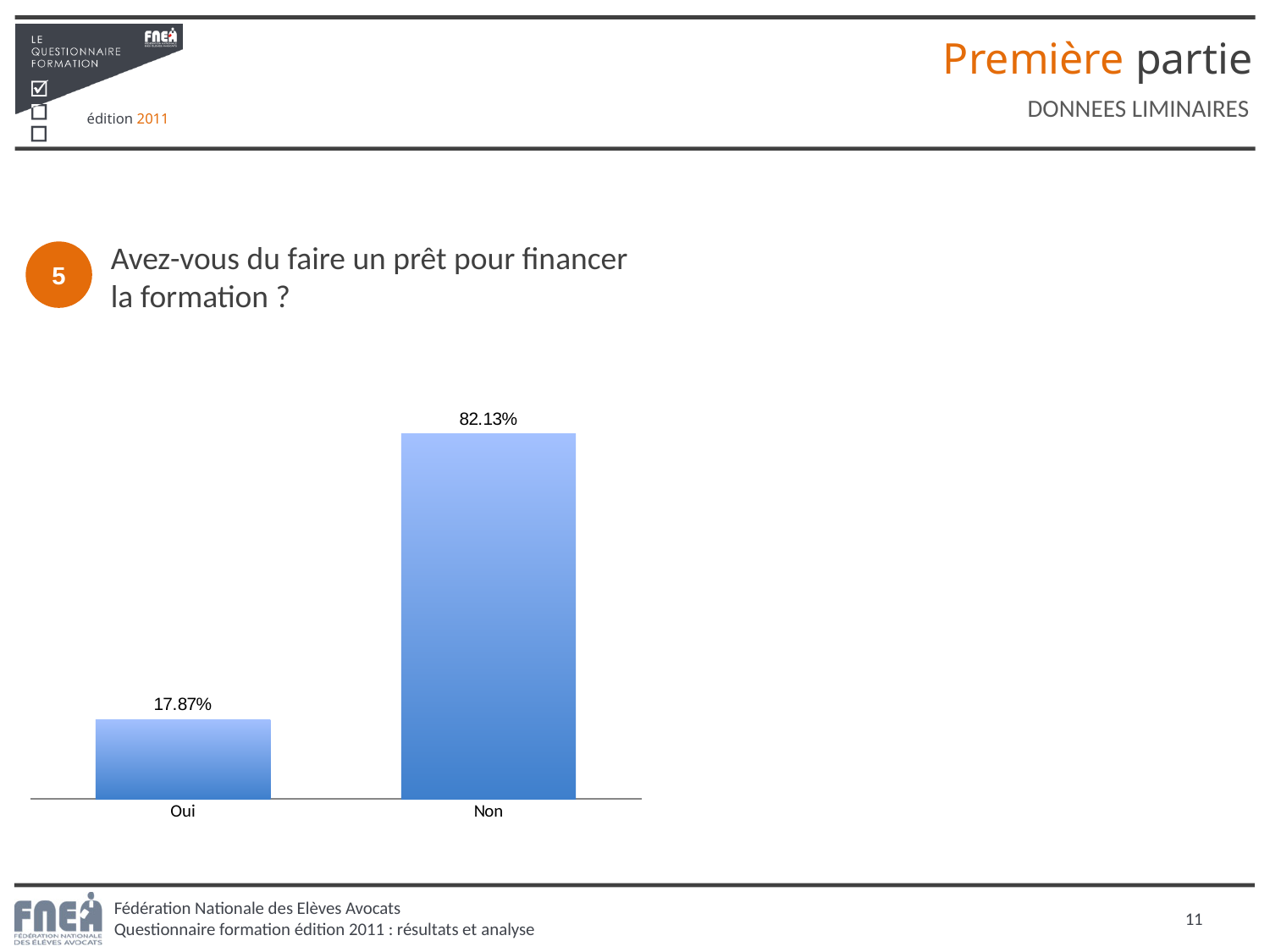
Which is larger, the value for Oui or the value for Non? Non What is the value for Oui? 17.87% How many categories are shown in the chart? 2 What question does the chart on the slide answer? Avez-vous du faire un prêt pour financer la formation ? What colour are the bars in the chart? blue What is the total of the two values shown in the chart? 100% What kind of chart is shown on the slide? bar chart What is the difference between the values for Non and Oui? 64.26% Which category has the lowest value? Oui Which category has the highest value? Non What is the value for Non? 82.13%